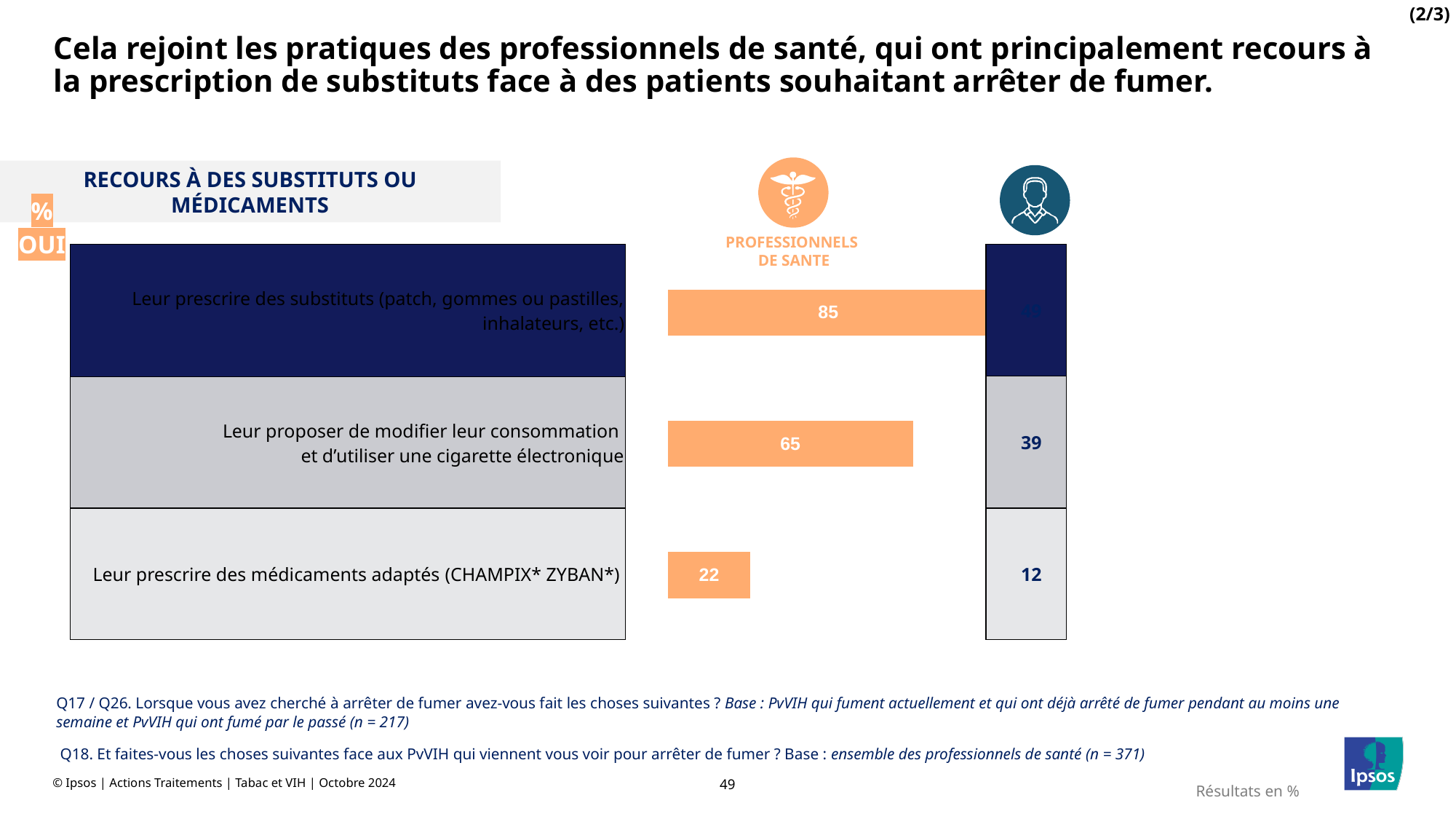
What is the difference between the professionnels de santé values for prescribing substituts (85) and prescribing médicaments adaptés (22)? 63 What value is shown for 'Leur prescrire des médicaments adaptés (CHAMPIX* ZYBAN*)' among professionnels de santé? 22 Which category has the highest value among professionnels de santé? Leur prescrire des substituts (patch, gommes ou pastilles, inhalateurs, etc.) In the right-hand column, what value is shown for 'Leur prescrire des médicaments adaptés (CHAMPIX* ZYBAN*)'? 12 Which category has the lowest value among professionnels de santé? Leur prescrire des médicaments adaptés (CHAMPIX* ZYBAN*) For 'Leur proposer de modifier leur consommation et d'utiliser une cigarette électronique', which is larger: the professionnels de santé value or the right-hand column value? Professionnels de santé (65) What value is shown for 'Leur proposer de modifier leur consommation et d'utiliser une cigarette électronique' among professionnels de santé? 65 In the right-hand column, what value is shown for 'Leur proposer de modifier leur consommation et d'utiliser une cigarette électronique'? 39 What type of chart is used to show the professionnels de santé values? Bar chart What colour are the bars for professionnels de santé? Orange What value is shown for 'Leur prescrire des substituts (patch, gommes ou pastilles, inhalateurs, etc.)' among professionnels de santé? 85 How many categories are shown in the chart? 3